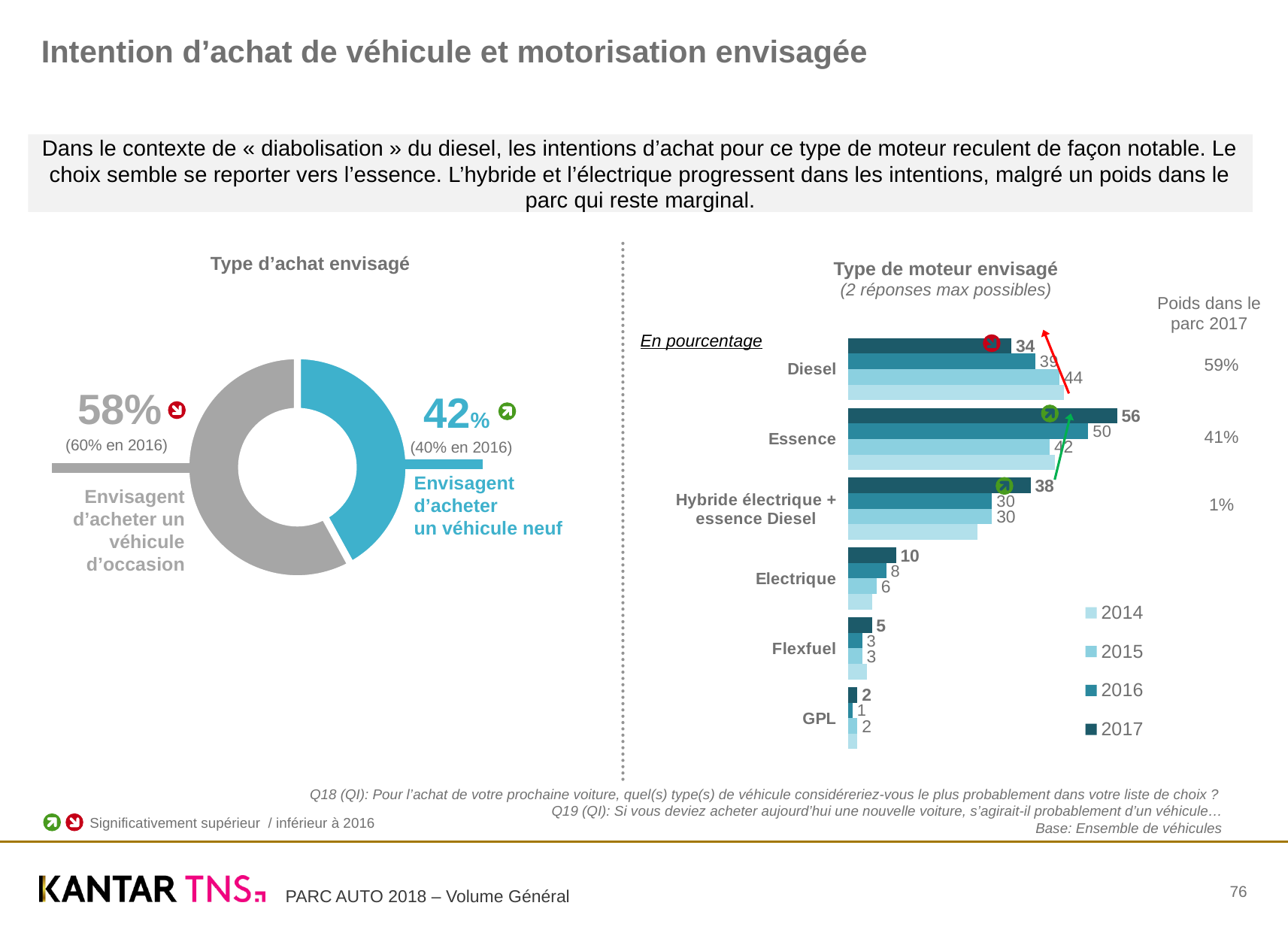
In the 'Type de moteur envisagé' chart, does the Diesel value rise or fall from 2015 to 2017? Fall In the 'Type de moteur envisagé' chart, what is the 2016 value for Hybride électrique + essence Diesel? 30 In the 'Type de moteur envisagé' chart, how many engine types are shown? 6 In the 'Type de moteur envisagé' chart, what is the 2017 value for Essence? 56 In the 'Type de moteur envisagé' chart, what is the difference between the 2017 values for Essence and Diesel? 22 What kind of chart is 'Type d'achat envisagé'? Donut (pie) chart In the 'Type de moteur envisagé' chart, which engine type has the highest 2017 value? Essence In the 'Type de moteur envisagé' chart, which engine type has the lowest 2017 value? GPL In the 'Type d'achat envisagé' chart, what share of respondents plan to buy a new vehicle (véhicule neuf)? 42% In the 'Type de moteur envisagé' chart, how many series does the legend list? 4 In the 'Type d'achat envisagé' chart, what share of respondents plan to buy a used vehicle (véhicule d'occasion)? 58% In the 'Type de moteur envisagé' chart, what is the 2017 value for Diesel? 34